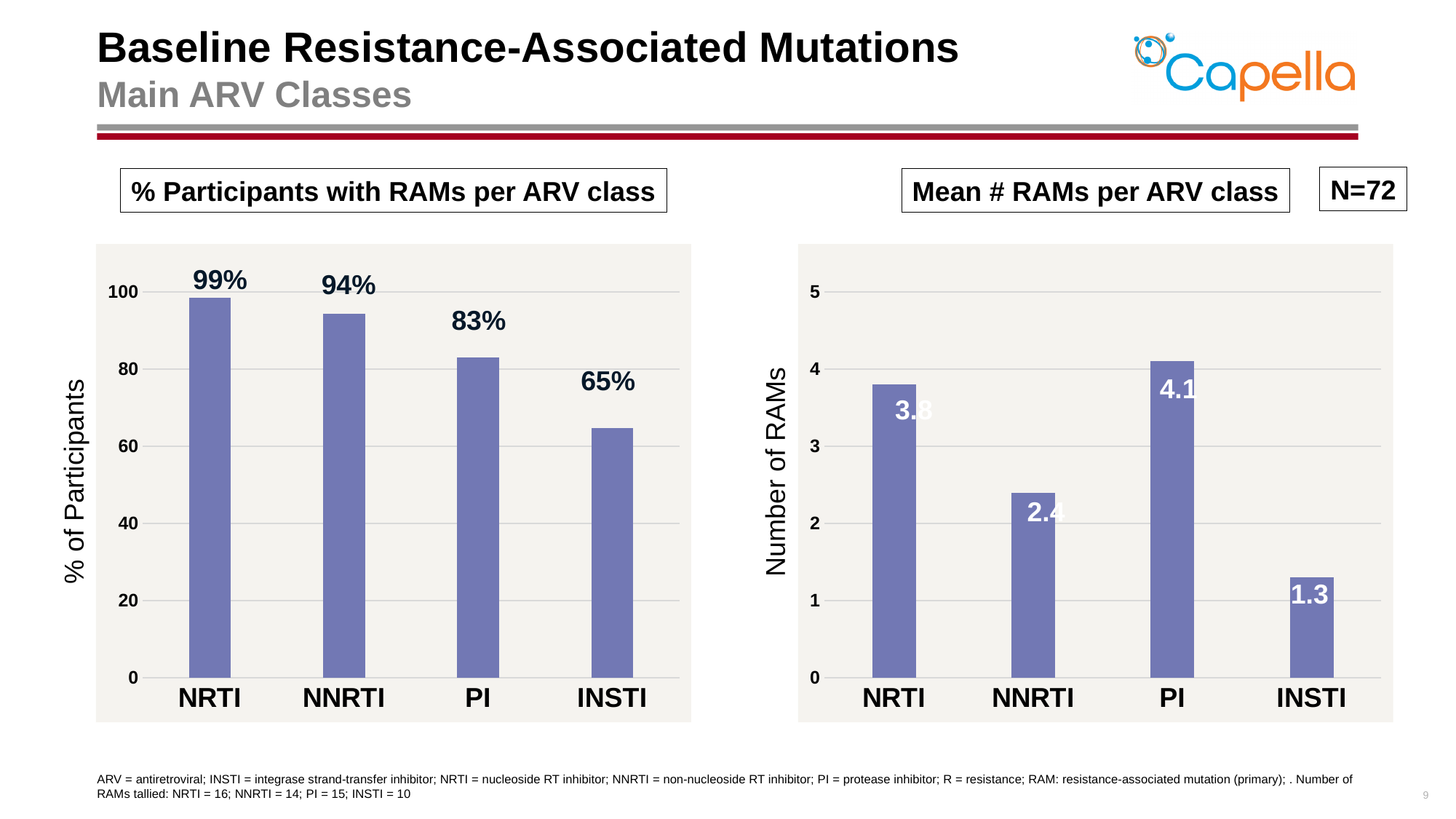
In the 'Mean # RAMs per ARV class' chart, what is the value for NNRTI? 2.4 What kind of chart is the 'Mean # RAMs per ARV class' chart? Bar chart In the 'Mean # RAMs per ARV class' chart, which ARV class has the highest mean number of RAMs? PI In the '% Participants with RAMs per ARV class' chart, which ARV class has the lowest percentage? INSTI In the 'Mean # RAMs per ARV class' chart, what is the value for PI? 4.1 In the '% Participants with RAMs per ARV class' chart, what is the value for INSTI? 65% In the 'Mean # RAMs per ARV class' chart, what is the difference between the PI and INSTI values? 2.8 In the '% Participants with RAMs per ARV class' chart, what is the difference between the NNRTI and PI values? 11% In the 'Mean # RAMs per ARV class' chart, which is larger, the value for NRTI or the value for INSTI? NRTI In the '% Participants with RAMs per ARV class' chart, what is the value for NRTI? 99% In the '% Participants with RAMs per ARV class' chart, how many ARV classes are shown? 4 What is the y-axis label of the '% Participants with RAMs per ARV class' chart? % of Participants